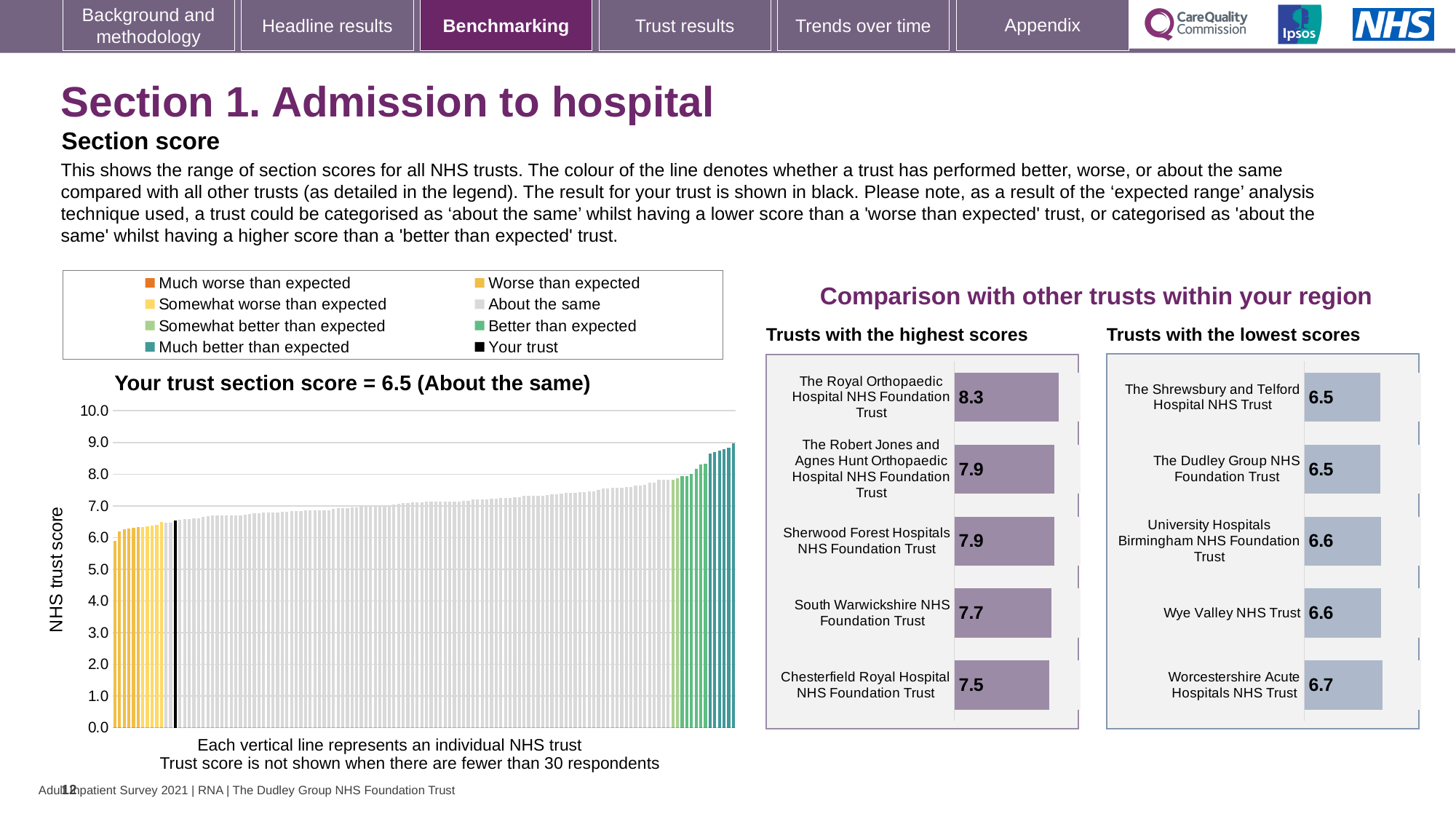
How many entries does the legend above the 'Your trust section score' chart list? 8 In the chart titled 'Your trust section score = 6.5 (About the same)', what kind of chart is used? Bar chart In the 'Trusts with the lowest scores' chart, which trust has the highest score? Worcestershire Acute Hospitals NHS Trust In the 'Trusts with the highest scores' chart, how many trusts are shown? 5 In the 'Trusts with the highest scores' chart, what is the difference between the scores of The Royal Orthopaedic Hospital NHS Foundation Trust and Chesterfield Royal Hospital NHS Foundation Trust? 0.8 In the 'Trusts with the lowest scores' chart, how many trusts are shown? 5 In the 'Trusts with the lowest scores' chart, what is the difference between the scores of Worcestershire Acute Hospitals NHS Trust and The Dudley Group NHS Foundation Trust? 0.2 In the 'Trusts with the lowest scores' chart, what is the score for Wye Valley NHS Trust? 6.6 In the chart titled 'Your trust section score = 6.5 (About the same)', do the trust scores rise or fall from left to right? Rise In the 'Trusts with the highest scores' chart, which trust has the lowest score? Chesterfield Royal Hospital NHS Foundation Trust In the 'Trusts with the highest scores' chart, what is the score for The Royal Orthopaedic Hospital NHS Foundation Trust? 8.3 In the 'Trusts with the highest scores' chart, which has the higher score: Sherwood Forest Hospitals NHS Foundation Trust or South Warwickshire NHS Foundation Trust? Sherwood Forest Hospitals NHS Foundation Trust